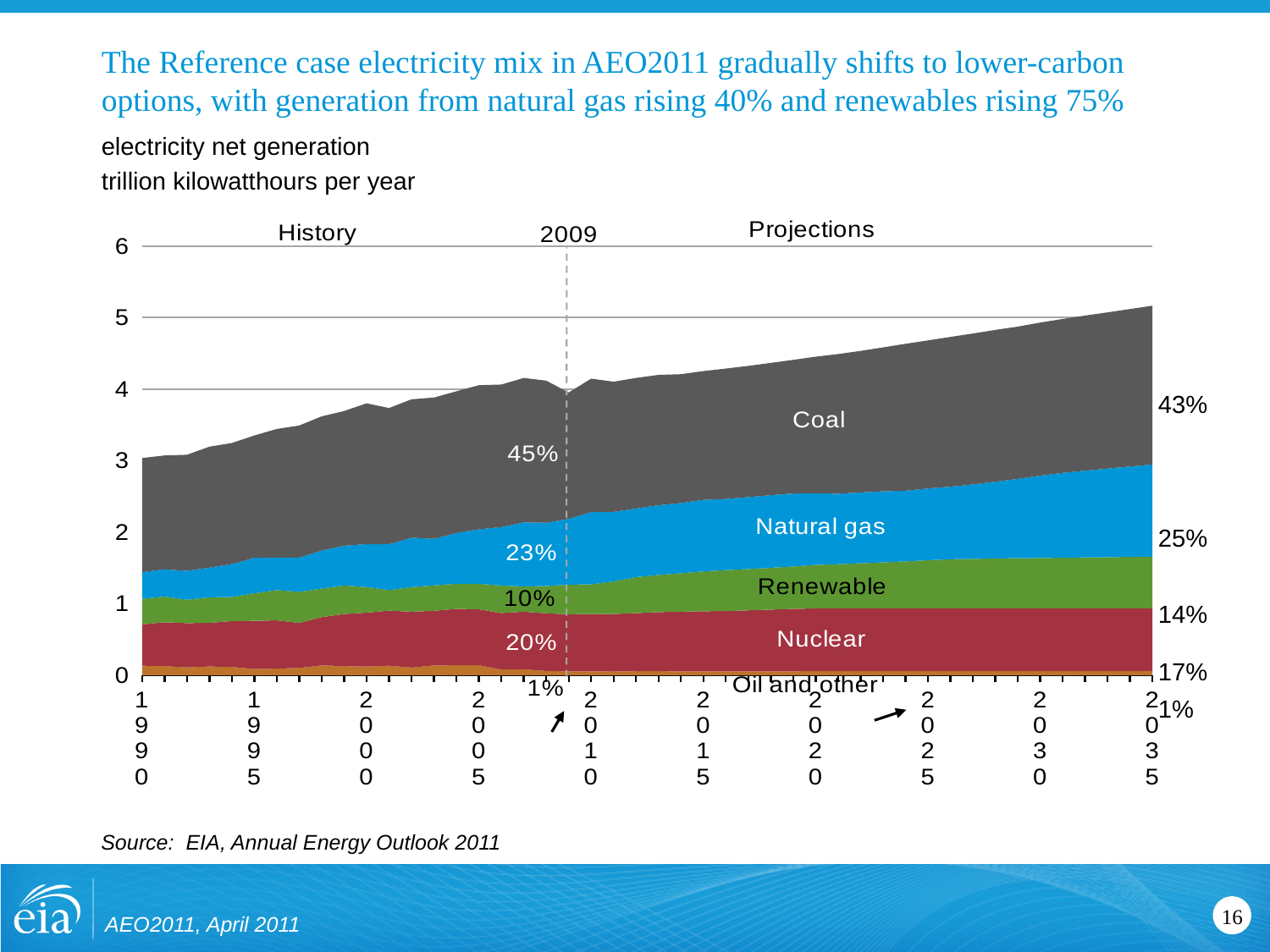
What share of electricity net generation does nuclear account for in 2035? 17% Does total electricity net generation rise or fall over the projection period from 2009 to 2035? Rise What share of electricity net generation does natural gas account for in 2035? 25% What share of electricity net generation does coal account for in 2009? 45% What kind of chart is shown on the slide? Stacked area chart Which generation source has the smallest share in 2035? Oil and other Which is larger in 2035, the share of renewable or the share of nuclear? Nuclear How many generation sources are labeled as areas in the chart? 5 What share of electricity net generation does renewable account for in 2009? 10% By how many percentage points does the coal share change from 2009 (45%) to 2035 (43%)? 2 percentage points Is total electricity net generation in 2009 greater or less than 5 trillion kilowatthours? less Which generation source has the largest share in 2009? Coal